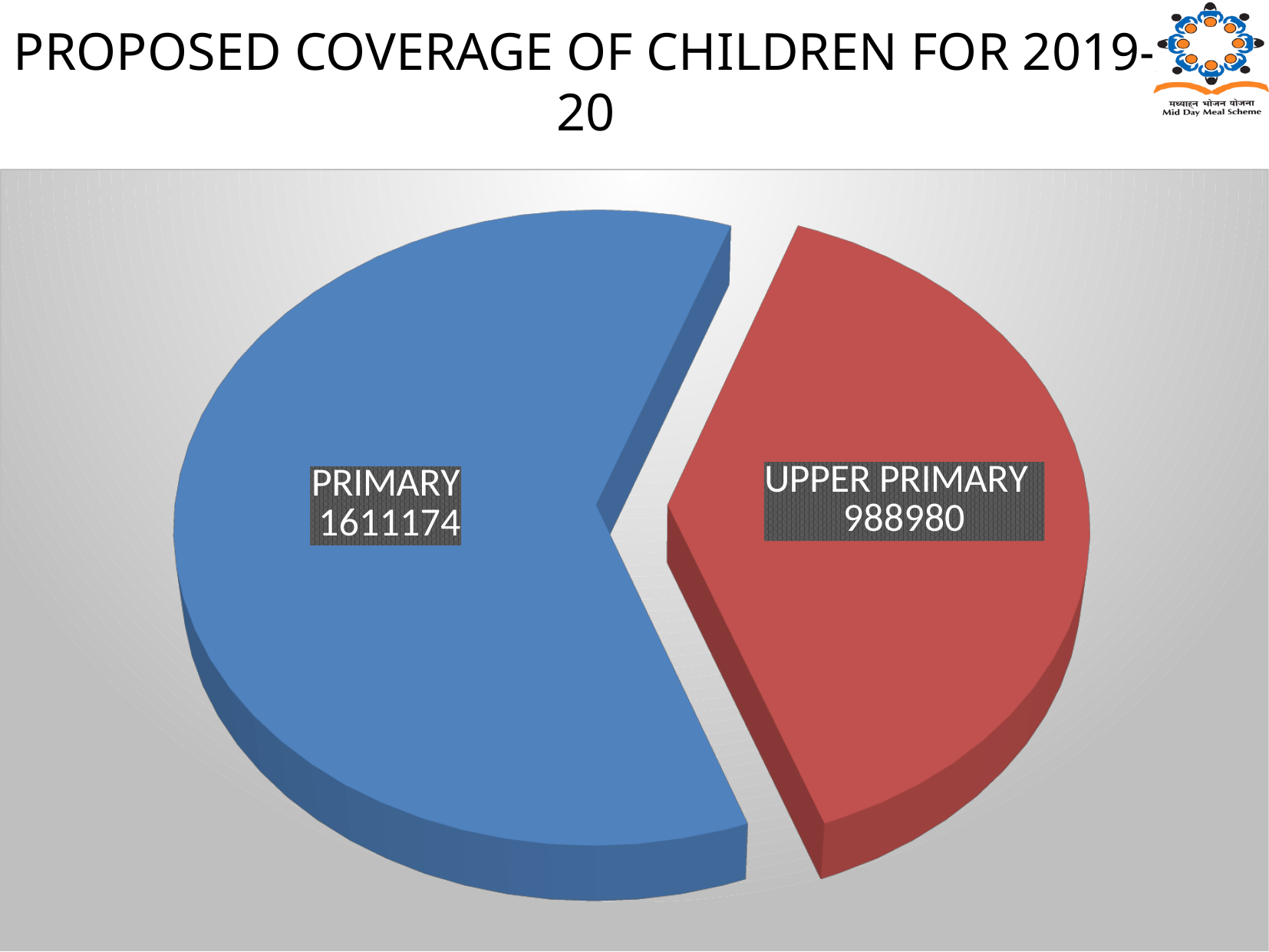
How many categories (slices) does the pie chart have? 2 Which is larger, the value for PRIMARY or the value for UPPER PRIMARY? PRIMARY What is the value for PRIMARY? 1611174 What colour is the UPPER PRIMARY slice? Red Which category has the largest slice of the pie? PRIMARY What is the value for UPPER PRIMARY? 988980 Which category has the smallest slice of the pie? UPPER PRIMARY What is the total of the two slices in the pie chart? 2600154 What is the title of the chart slide? PROPOSED COVERAGE OF CHILDREN FOR 2019-20 What is the difference between the PRIMARY and UPPER PRIMARY values? 622194 What type of chart is shown on the slide? Pie chart